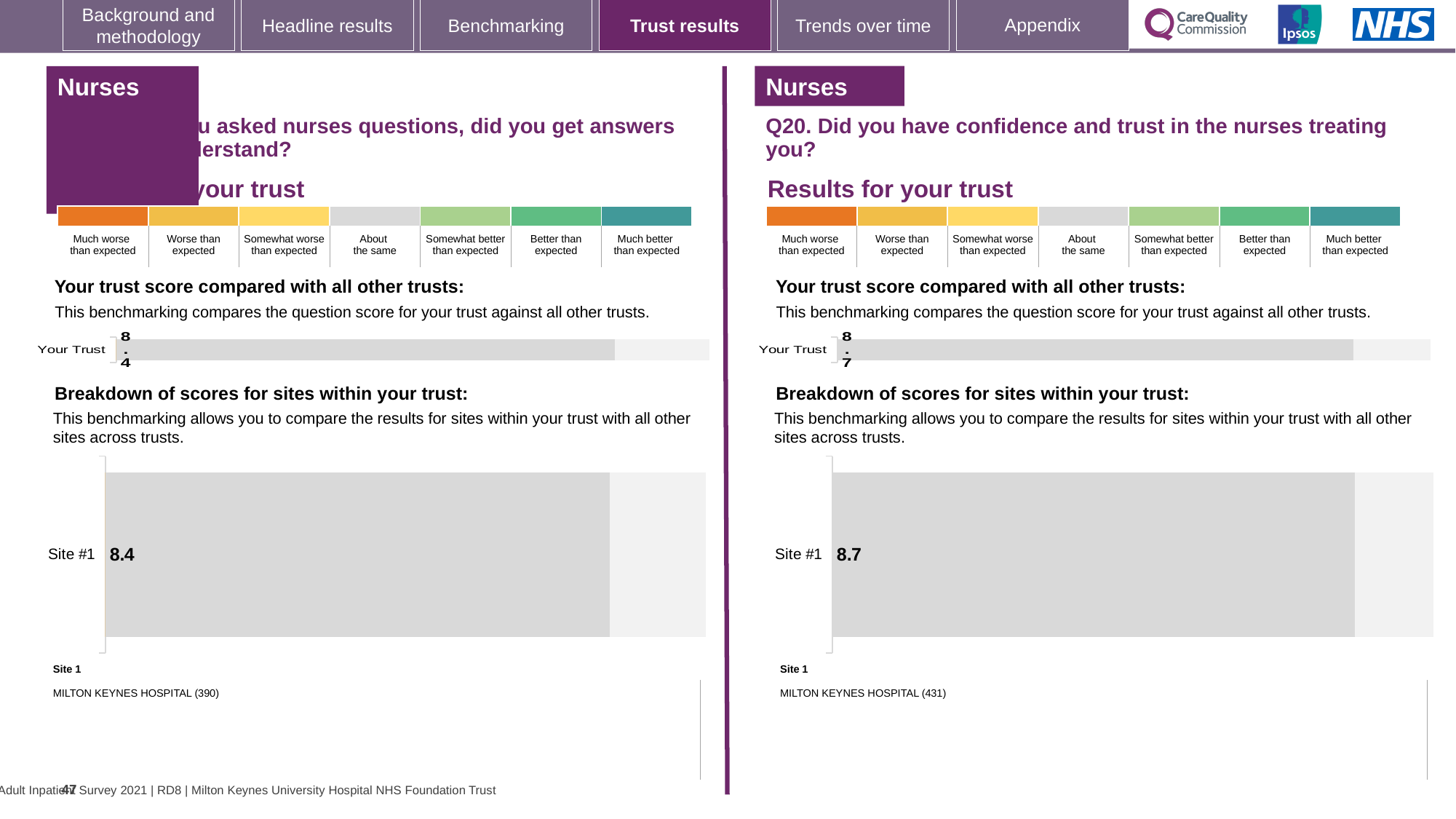
What is the difference between the Site #1 score on the right half of the slide (Q20) and the Site #1 score on the left half? 0.3 Which is larger: the 'Your Trust' score on the left half of the slide or the 'Your Trust' score on the right half (Q20)? The right half (Q20), 8.7 Which hospital is listed as Site 1 below the site breakdown chart on the right half of the slide (Q20)? MILTON KEYNES HOSPITAL (431) What kind of chart is used for the 'Breakdown of scores for sites within your trust' on the right half of the slide (Q20)? Bar chart On the left half of the slide, what is the score shown for 'Your Trust' in the 'Your trust score compared with all other trusts' chart? 8.4 In the 'Breakdown of scores for sites within your trust' chart on the left half of the slide, what is the value for Site #1? 8.4 What is the question text shown above the charts on the right half of the slide? Q20. Did you have confidence and trust in the nurses treating you? In the 'Breakdown of scores for sites within your trust' chart on the right half of the slide (Q20), what is the value for Site #1? 8.7 What kind of chart is used to show the 'Your Trust' score on the left half of the slide? Bar chart How many sites are shown in the 'Breakdown of scores for sites within your trust' chart on the right half of the slide (Q20)? 1 On the right half of the slide (Q20), what is the score shown for 'Your Trust' in the 'Your trust score compared with all other trusts' chart? 8.7